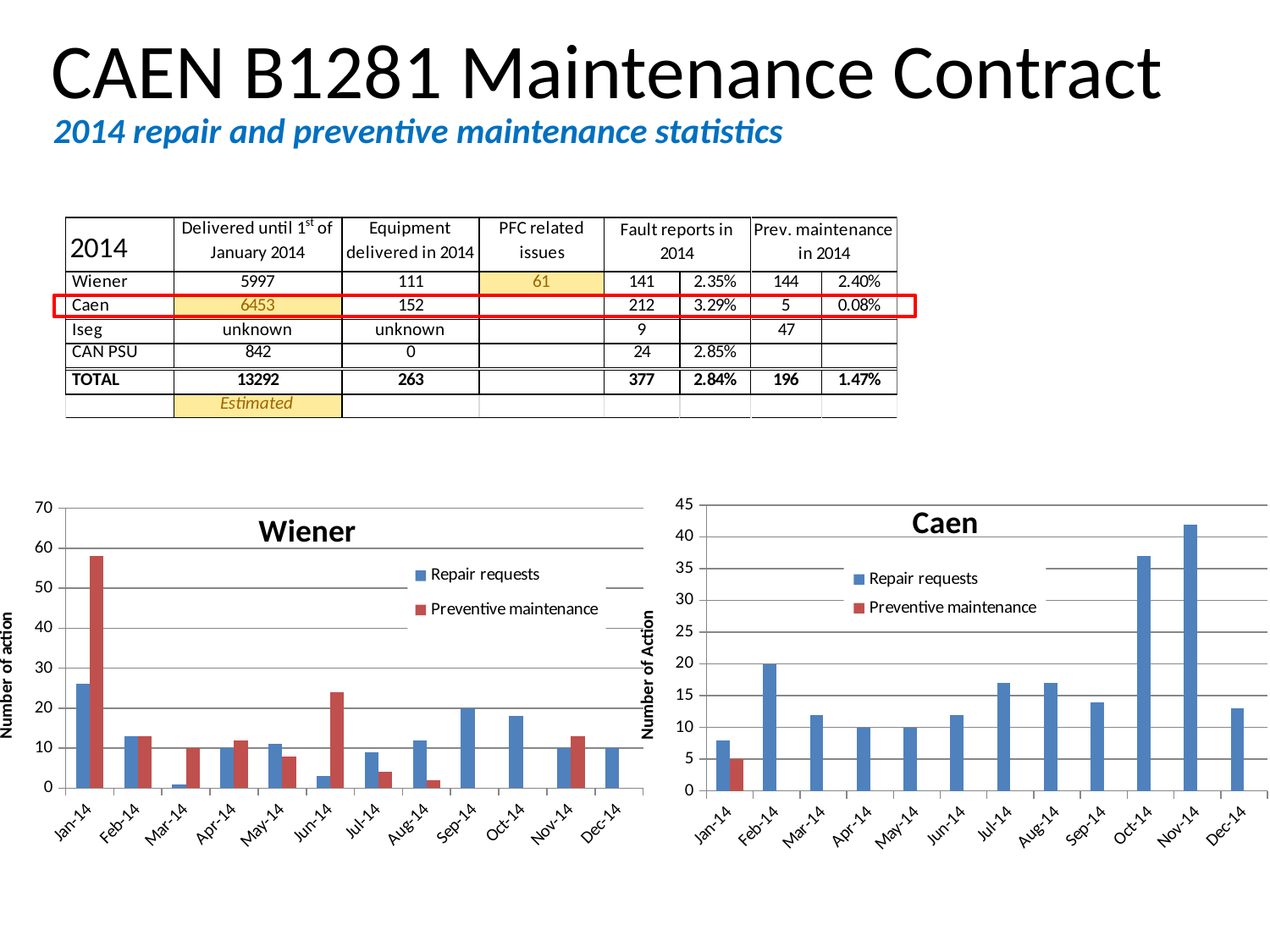
In the Caen chart, which month has the highest number of repair requests? Nov-14 In the Wiener chart, which month has the lowest number of repair requests? Mar-14 How many months are shown on the x axis of the Wiener chart? 12 What kind of chart is the Wiener chart? Bar chart In the Wiener chart, which is larger in Jun-14: repair requests or preventive maintenance? Preventive maintenance In the Caen chart, is the repair requests value for Feb-14 greater or less than 15? greater In the Caen chart, is the repair requests value for Oct-14 greater or less than 30? greater In the Caen chart, which is larger in Jan-14: repair requests or preventive maintenance? Repair requests In the Wiener chart, is the repair requests value for Jan-14 greater or less than 20? greater How many series does the legend of the Caen chart list? 2 In the Wiener chart, which month has the highest preventive maintenance value? Jan-14